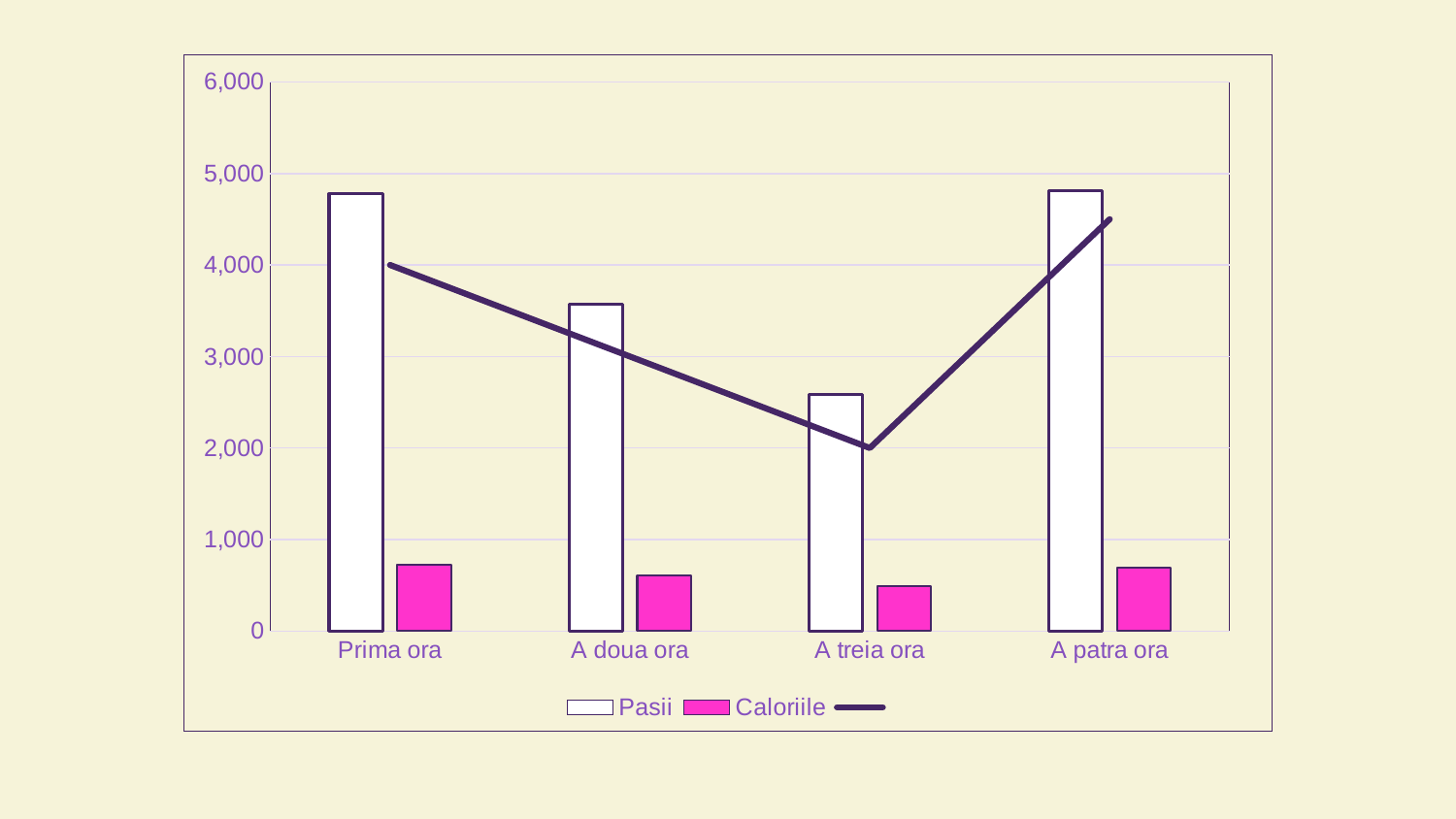
Which has the larger Pasii value, A doua ora or A treia ora? A doua ora Does the line series rise or fall from Prima ora to A treia ora? fall Is the Caloriile value for A patra ora greater or less than 1,000? less Is the Pasii value for Prima ora greater or less than 4,000? greater Is the line series value at A patra ora greater or less than 4,000? greater Which category has the lowest Pasii value? A treia ora Which category has the lowest Caloriile value? A treia ora What kind of chart is shown on the slide? bar chart with a line How many series are plotted as bars? 2 What colour are the Caloriile bars? magenta How many categories are shown on the x axis? 4